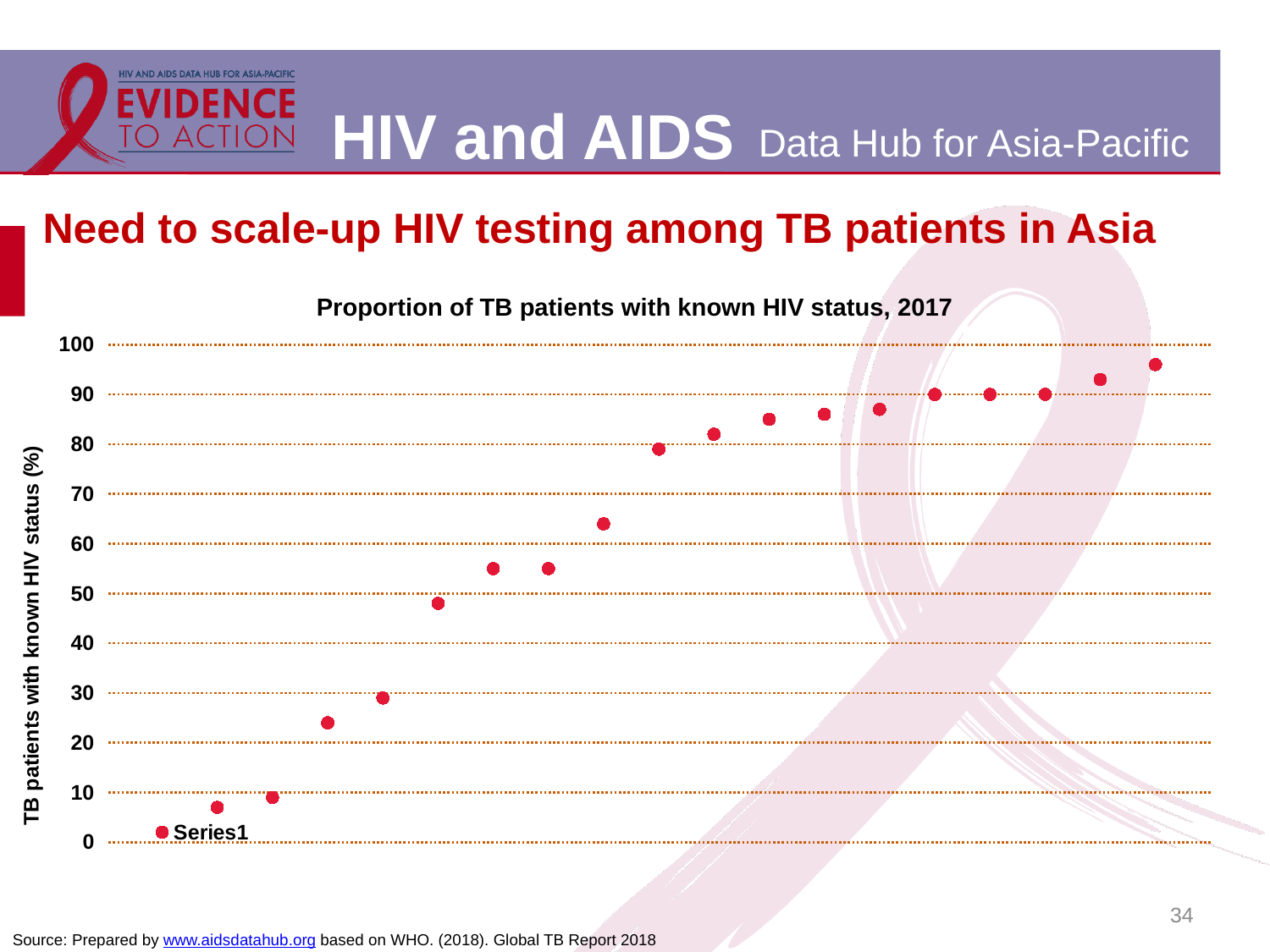
Is the value of the leftmost point greater or less than 10? less Which point has the higher value, the leftmost point or the rightmost point? the rightmost point What is the maximum value shown on the y axis? 100 Is the value of the lowest point greater or less than 20? less Is the value of the rightmost point greater or less than 90? greater What kind of chart is shown on the slide? scatter (dot) chart Do the plotted values rise or fall from left to right along the x axis? rise How many data points are plotted on the chart? 19 What is the title of the chart? Proportion of TB patients with known HIV status, 2017